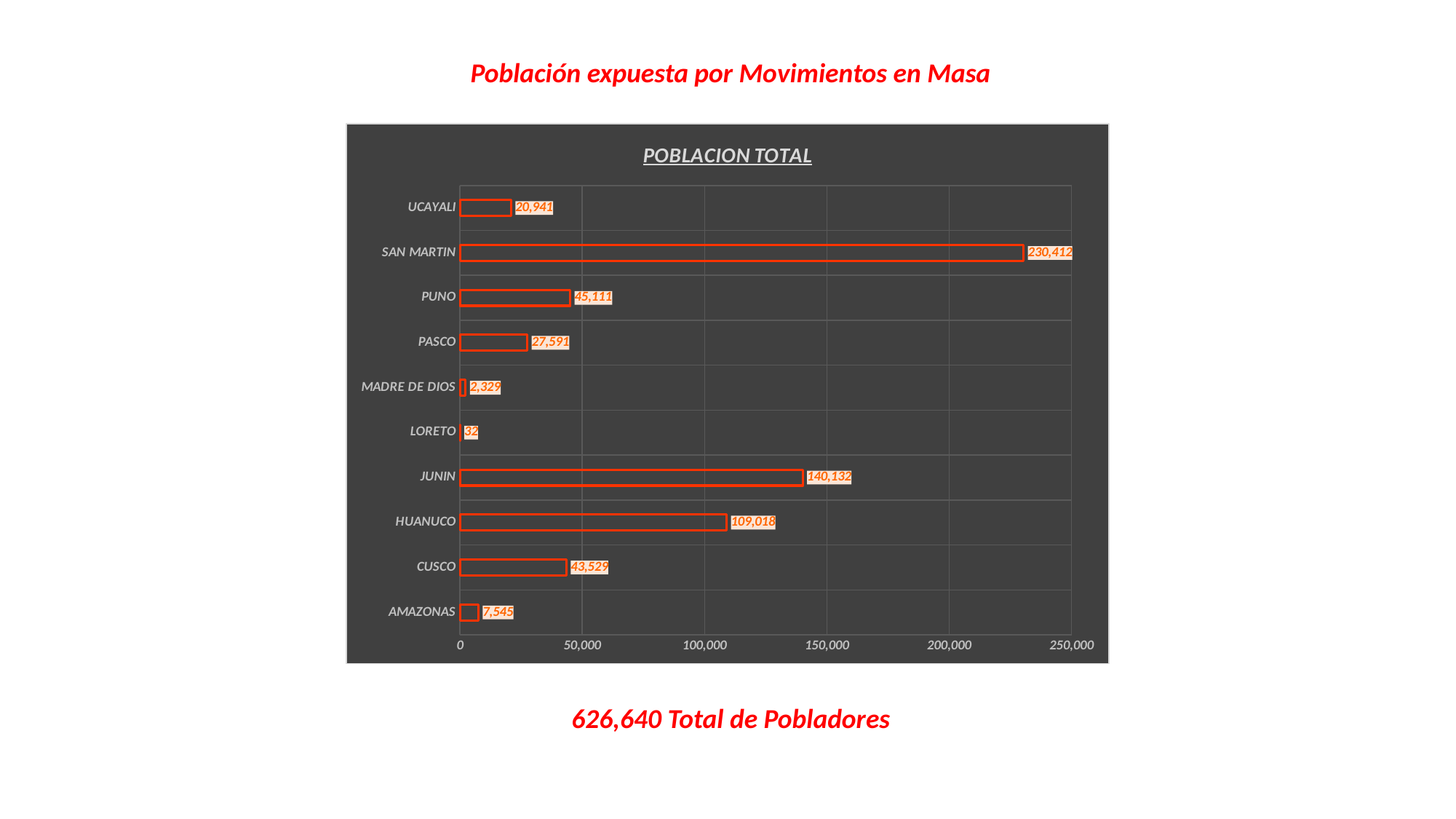
Which is larger, the value for HUANUCO or the value for PUNO? HUANUCO How many categories are shown in the chart? 10 What is the value for JUNIN? 140,132 Which category has the lowest value? LORETO What is the title of the chart? POBLACION TOTAL Which category has the highest value? SAN MARTIN Is the value for HUANUCO greater or less than 100,000? greater What kind of chart is shown on the slide? bar chart What is the difference between the values for PUNO and CUSCO? 1,582 What is the value for MADRE DE DIOS? 2,329 What is the value for SAN MARTIN? 230,412 What is the difference between the values for SAN MARTIN and JUNIN? 90,280